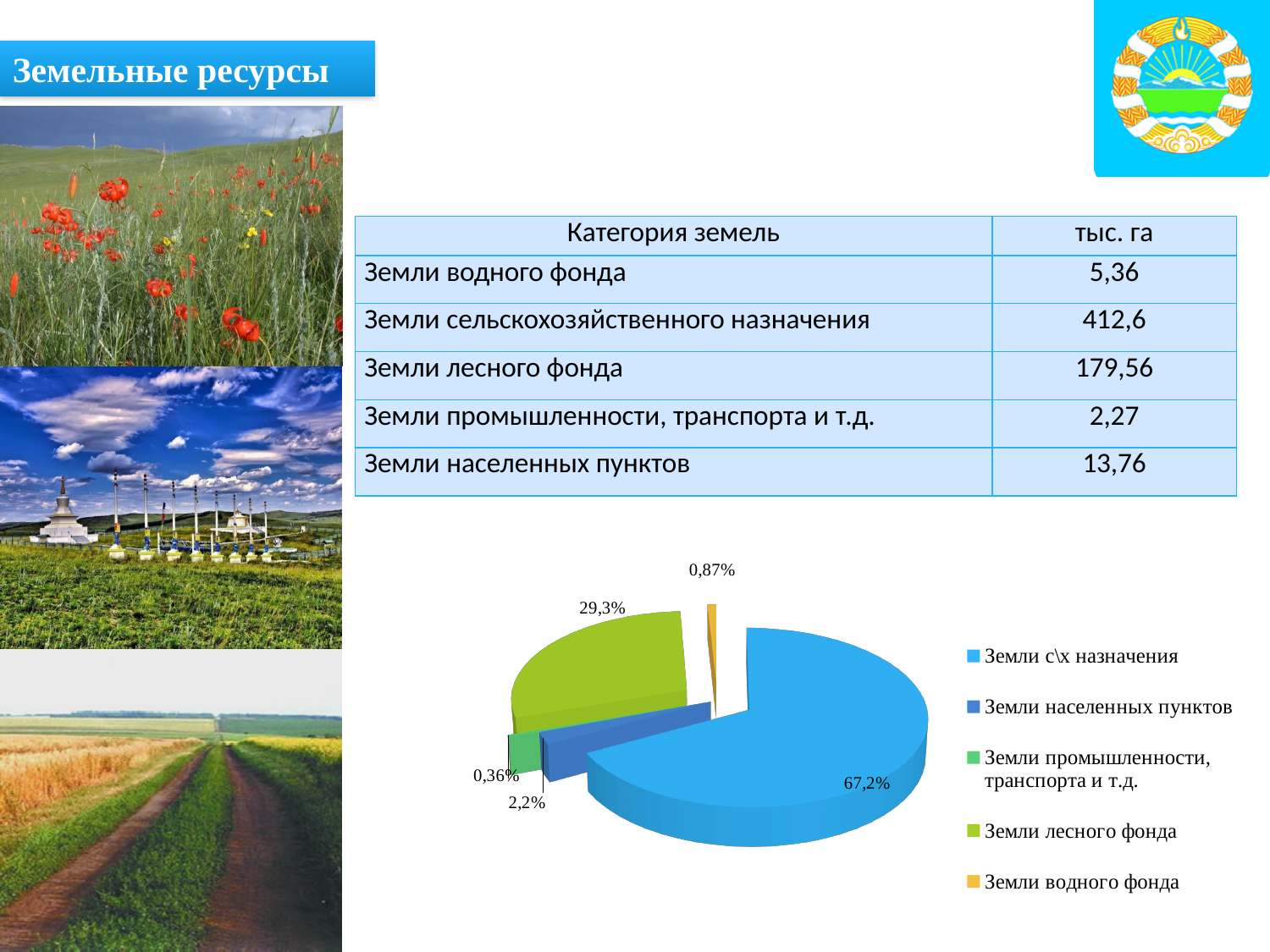
Which category has the largest slice in the pie chart? Земли с\х назначения What kind of chart is shown on the slide? pie chart What share of the pie chart does "Земли водного фонда" have? 0,87% Which category has the smallest slice in the pie chart? Земли промышленности, транспорта и т.д. What share of the pie chart does "Земли населенных пунктов" have? 2,2% What is the difference in percentage points between the "Земли с\х назначения" slice and the "Земли лесного фонда" slice? 37,9 What share of the pie chart does "Земли промышленности, транспорта и т.д." have? 0,36% What share of the pie chart does "Земли с\х назначения" have? 67,2% Which slice is larger in the pie chart: "Земли населенных пунктов" or "Земли водного фонда"? Земли населенных пунктов What share of the pie chart does "Земли лесного фонда" have? 29,3% What colour is the "Земли лесного фонда" slice in the pie chart? green How many slices does the pie chart have? 5